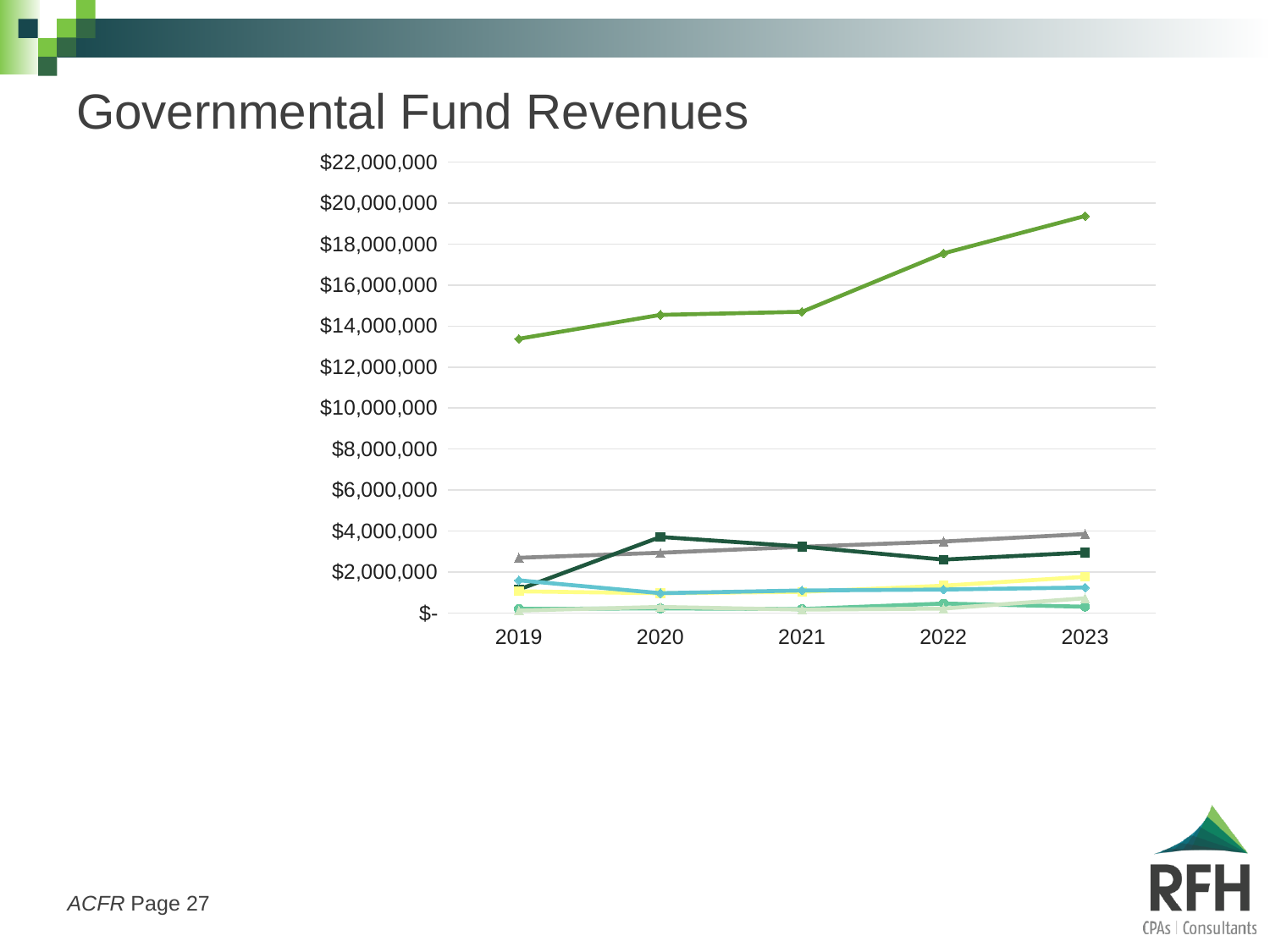
In which year does the topmost line reach its highest value? 2023 What kind of chart is shown on the slide? line chart Is the value of the topmost line in 2021 greater or less than $16,000,000? less In which year does the dark green line with square markers reach its highest value? 2020 Is the value of the topmost line in 2023 greater or less than $18,000,000? greater Is the value of the topmost line in 2022 greater or less than $16,000,000? greater How many years are shown along the x axis of the chart? 5 In which year does the topmost line have its lowest value? 2019 For the topmost line, which year has the larger value, 2019 or 2023? 2023 Does the topmost line in the chart rise or fall from 2019 to 2023? rise What is the title of the chart on the slide? Governmental Fund Revenues